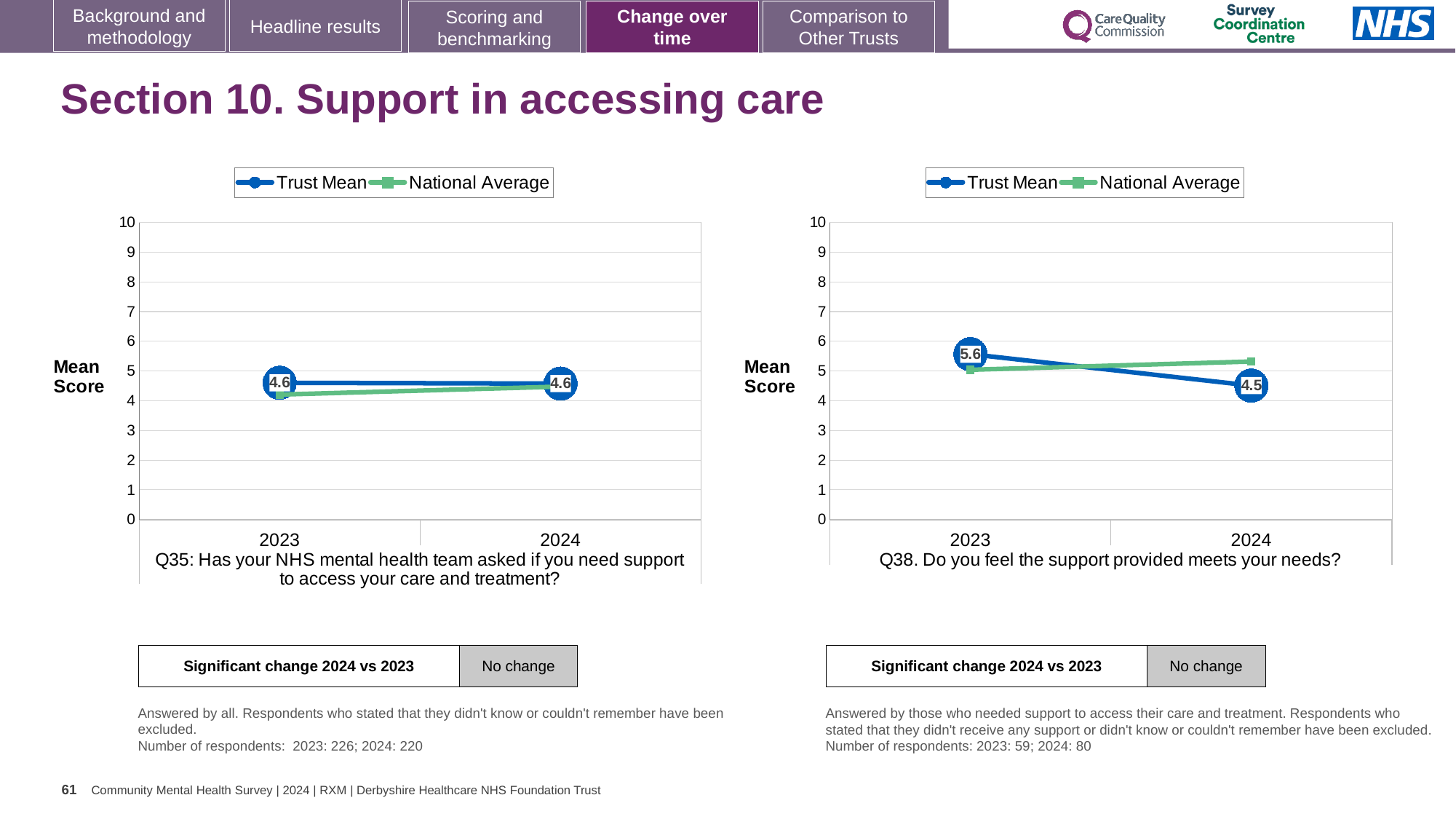
What kind of chart is the Q35 chart (left)? line chart In the Q38 chart (right), what is the Trust Mean score for 2024? 4.5 In the Q35 chart (left), what is the Trust Mean score for 2024? 4.6 In the Q38 chart (right), which year has the higher Trust Mean score, 2023 or 2024? 2023 In the Q38 chart (right), is the National Average for 2024 greater or less than 6? less In the Q35 chart (left), is the National Average for 2023 greater or less than 5? less In the Q38 chart (right), does the Trust Mean rise or fall from 2023 to 2024? fall In the Q38 chart (right), what is the Trust Mean score for 2023? 5.6 In the Q38 chart (right), by how much did the Trust Mean score fall from 2023 to 2024? 1.1 How many years are plotted on the x axis of the Q38 chart (right)? 2 How many series does the legend of the Q35 chart (left) list? 2 In the Q35 chart (left), what is the Trust Mean score for 2023? 4.6